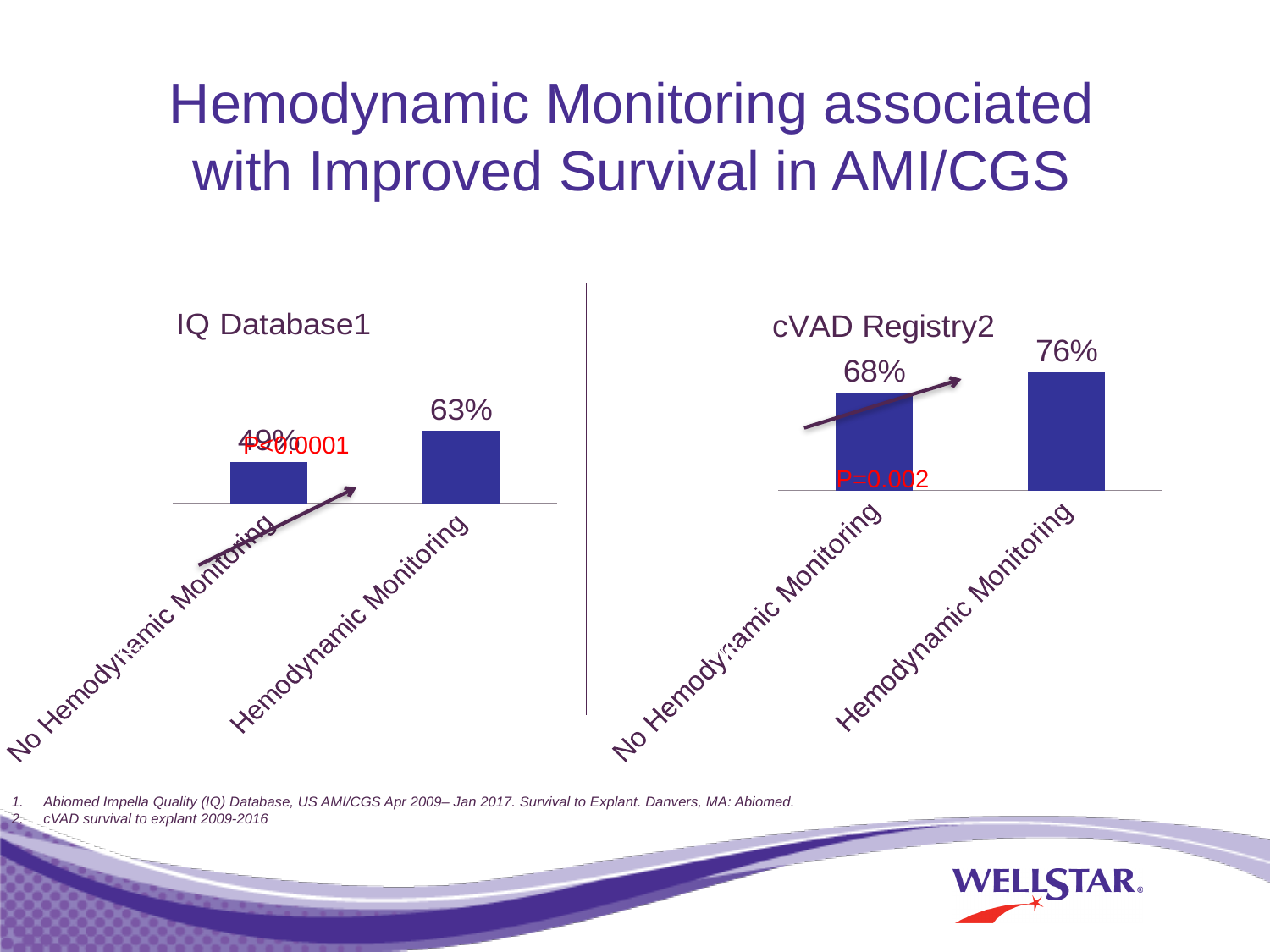
What p-value is printed on the cVAD Registry2 chart? P=0.002 In the cVAD Registry2 chart, what is the difference between the Hemodynamic Monitoring and No Hemodynamic Monitoring values? 8% What kind of chart is the cVAD Registry2 chart? Bar chart In the cVAD Registry2 chart, what is the value for Hemodynamic Monitoring? 76% In the cVAD Registry2 chart, which category has the highest value? Hemodynamic Monitoring In the cVAD Registry2 chart, what is the value for No Hemodynamic Monitoring? 68% In the cVAD Registry2 chart, which is larger: the value for Hemodynamic Monitoring or the value for No Hemodynamic Monitoring? Hemodynamic Monitoring In the IQ Database1 chart, which category has the highest value? Hemodynamic Monitoring How many categories are shown in the IQ Database1 chart? 2 How many categories are shown in the cVAD Registry2 chart? 2 In the IQ Database1 chart, what is the value for Hemodynamic Monitoring? 63% In the IQ Database1 chart, which category has the lowest value? No Hemodynamic Monitoring